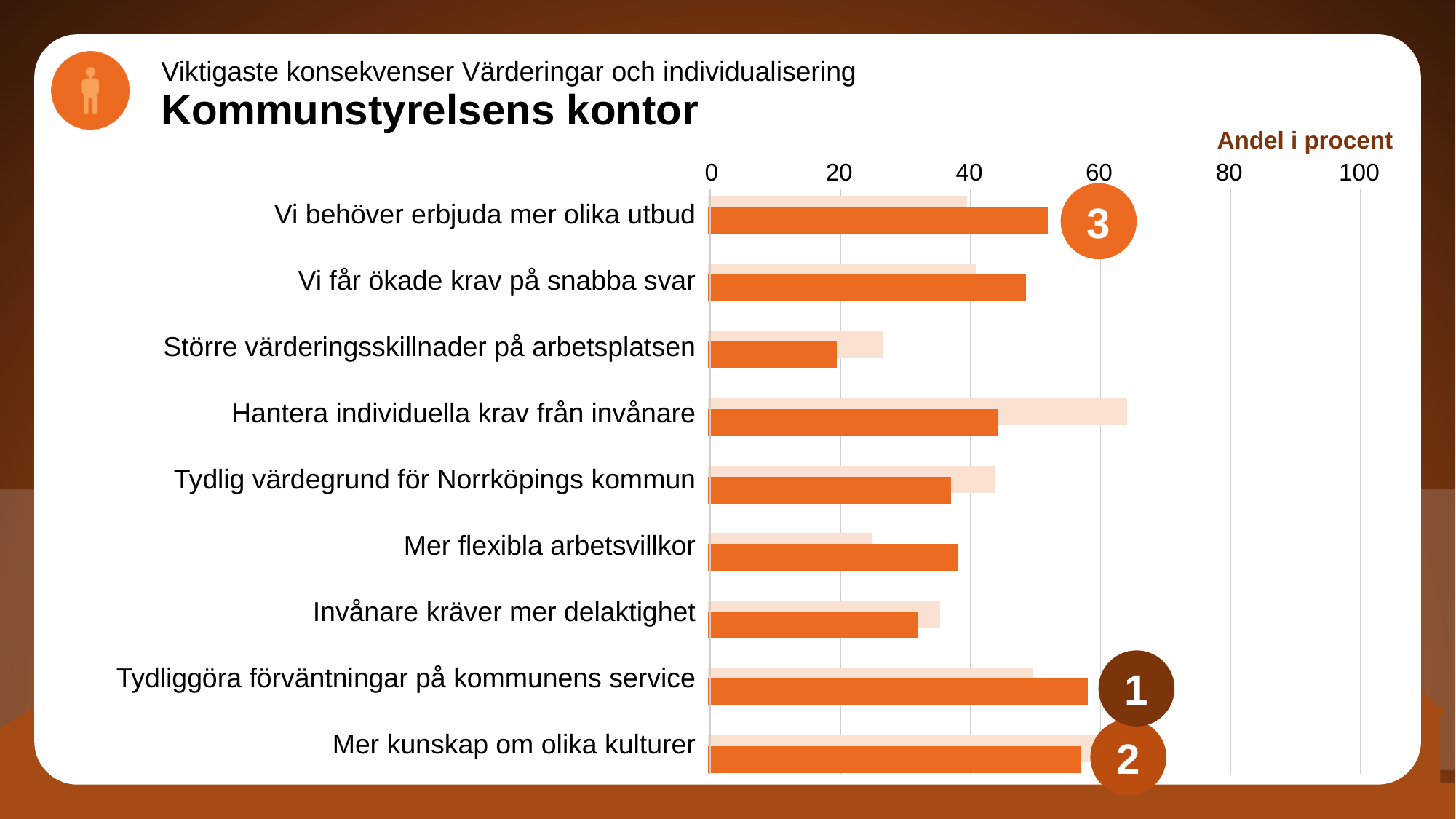
Is the dark orange bar for 'Invånare kräver mer delaktighet' greater or less than 40? less Which has the longer dark orange bar: 'Tydliggöra förväntningar på kommunens service' or 'Invånare kräver mer delaktighet'? Tydliggöra förväntningar på kommunens service Is the light orange bar for 'Hantera individuella krav från invånare' greater or less than 60? greater What is the label shown above the horizontal axis of the chart? Andel i procent Which has the longer dark orange bar: 'Vi behöver erbjuda mer olika utbud' or 'Hantera individuella krav från invånare'? Vi behöver erbjuda mer olika utbud Which category has the lowest dark orange bar? Större värderingsskillnader på arbetsplatsen What kind of chart is shown on the slide? bar chart How many categories are listed on the chart? 9 Which category is marked with the circle numbered 1? Tydliggöra förväntningar på kommunens service Is the dark orange bar for 'Större värderingsskillnader på arbetsplatsen' greater or less than 40? less